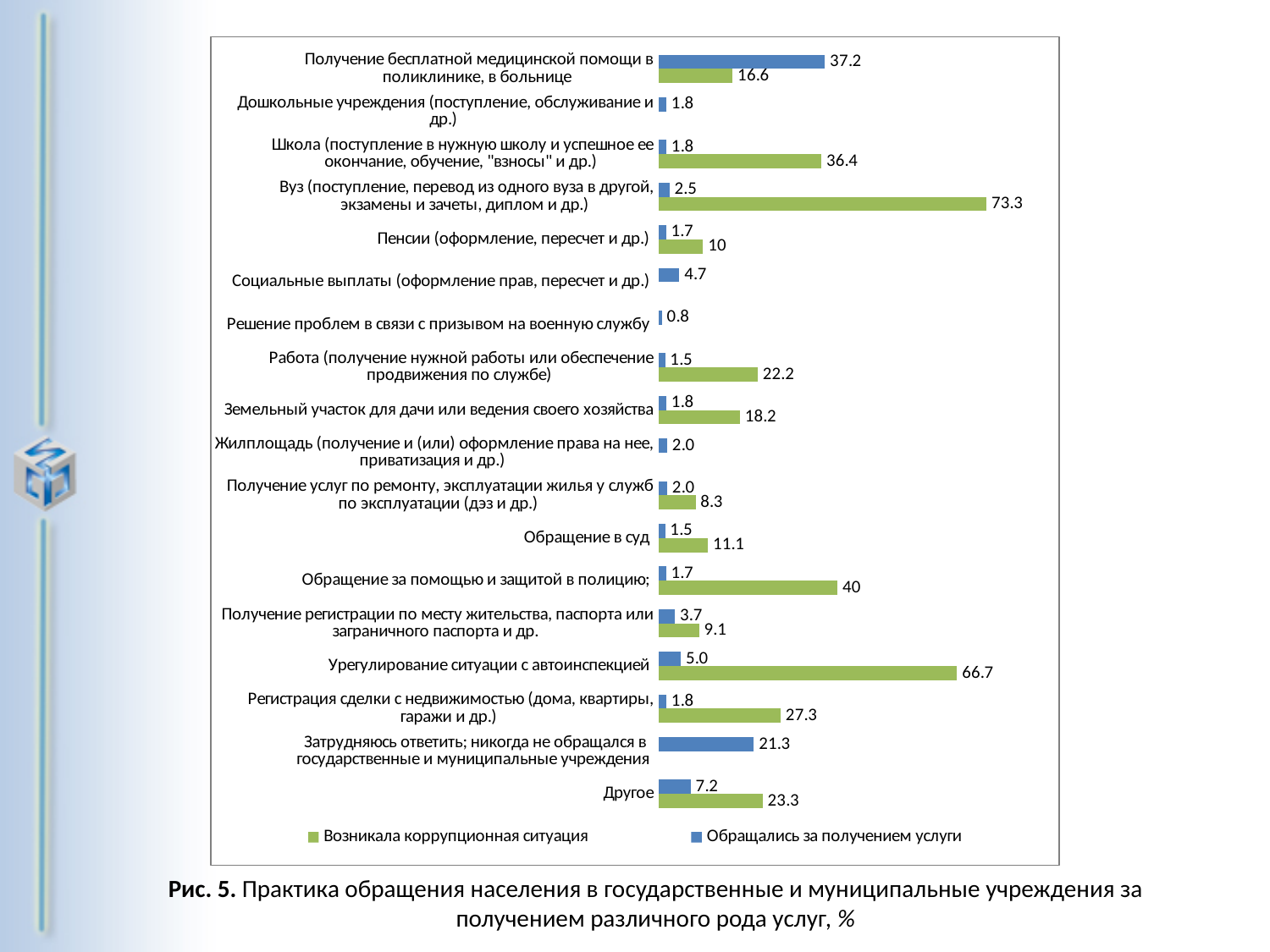
How many series does the legend list? 2 What is the value of "Возникала коррупционная ситуация" for "Урегулирование ситуации с автоинспекцией"? 66.7 What is the value of "Обращались за получением услуги" for "Затрудняюсь ответить; никогда не обращался в государственные и муниципальные учреждения"? 21.3 Which category has the lowest value for "Обращались за получением услуги"? Решение проблем в связи с призывом на военную службу What type of chart is shown on the slide? Bar chart What is the difference between the "Возникала коррупционная ситуация" values for "Обращение за помощью и защитой в полицию;" and "Обращение в суд"? 28.9 What is the value of "Обращались за получением услуги" for "Получение бесплатной медицинской помощи в поликлинике, в больнице"? 37.2 How many categories are shown on the chart? 18 Which category has the highest value for "Обращались за получением услуги"? Получение бесплатной медицинской помощи в поликлинике, в больнице Which category has the highest value for "Возникала коррупционная ситуация"? Вуз (поступление, перевод из одного вуза в другой, экзамены и зачеты, диплом и др.) What is the value of "Возникала коррупционная ситуация" for "Вуз (поступление, перевод из одного вуза в другой, экзамены и зачеты, диплом и др.)"? 73.3 Which is larger for "Школа (поступление в нужную школу и успешное ее окончание, обучение, "взносы" и др.)": "Возникала коррупционная ситуация" or "Обращались за получением услуги"? Возникала коррупционная ситуация